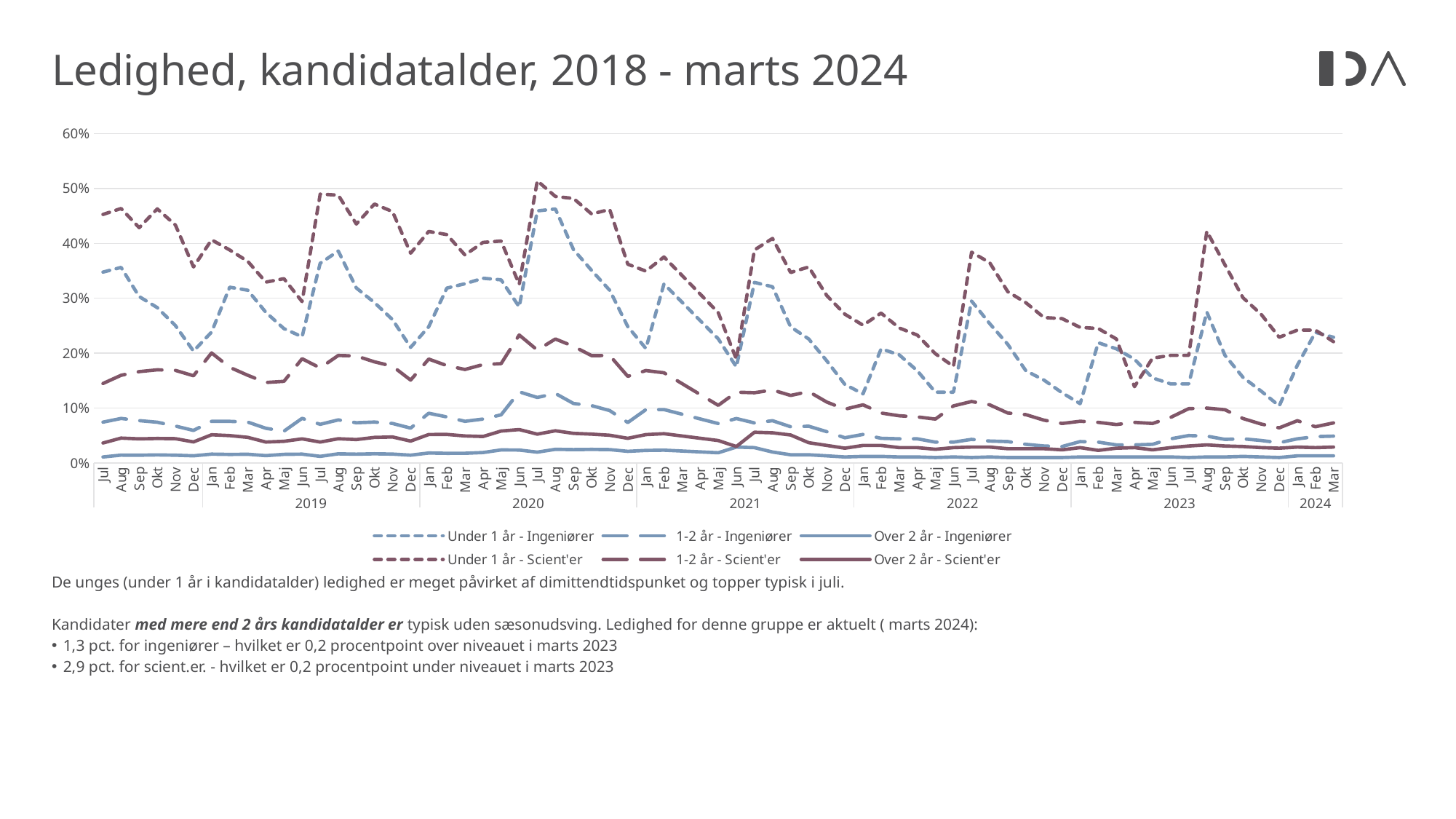
How many series does the legend list? 6 Is the value for Under 1 år - Scient'er in Jul 2020 greater or less than 40%? greater How many year labels are shown along the x axis? 6 Which series reaches the highest value anywhere on the chart? Under 1 år - Scient'er What is the title of the chart? Ledighed, kandidatalder, 2018 - marts 2024 What kind of chart is shown on the slide? line chart What is the highest tick value shown on the y axis? 60% In Jul 2018, which is larger: Under 1 år - Scient'er or Under 1 år - Ingeniører? Under 1 år - Scient'er Does the Under 1 år - Scient'er series rise or fall from Aug 2023 to Dec 2023? fall Which series stays lowest across the whole chart? Over 2 år - Ingeniører Is the value for Over 2 år - Ingeniører in Jul 2018 greater or less than 10%? less Is the value for Under 1 år - Ingeniører in Jul 2020 greater or less than 40%? greater